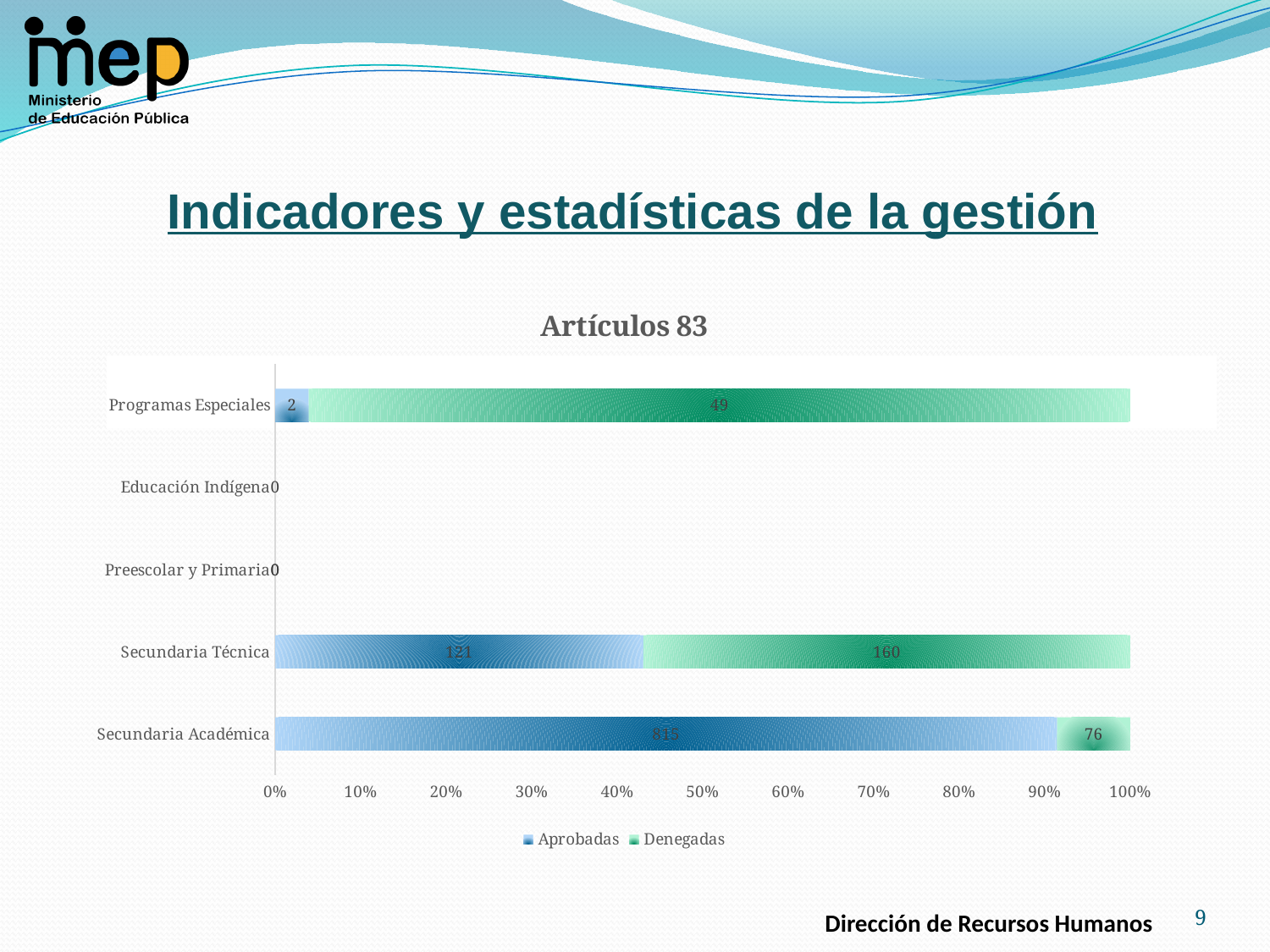
What is the Aprobadas value for Programas Especiales? 2 What is the Aprobadas value for Secundaria Académica? 815 What is the Denegadas value for Secundaria Técnica? 160 What is the Denegadas value for Secundaria Académica? 76 What kind of chart is shown on the slide? bar chart Which is larger for Programas Especiales, the Aprobadas value or the Denegadas value? Denegadas Which category has the highest Aprobadas value? Secundaria Académica What is the difference between the Denegadas and Aprobadas values for Secundaria Técnica? 39 How many categories are shown on the vertical axis of the chart? 5 How many series does the legend list? 2 What is the total of the Aprobadas and Denegadas values for Secundaria Académica? 891 What is the title of the chart? Artículos 83